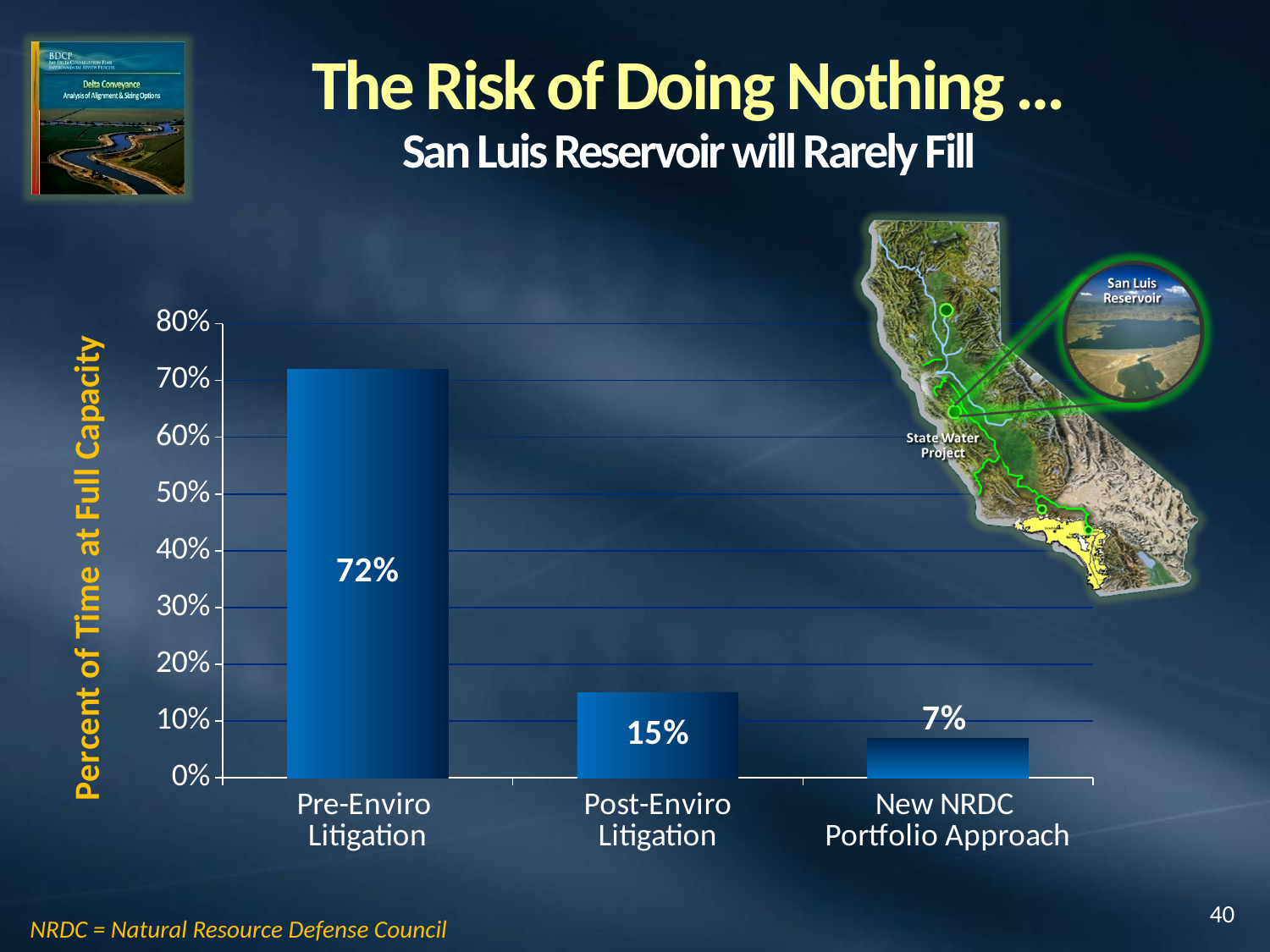
What is the value for New NRDC Portfolio Approach? 7% How many categories are shown on the x axis? 3 What kind of chart is shown on the slide? bar chart Which is larger, the value for Post-Enviro Litigation or the value for New NRDC Portfolio Approach? Post-Enviro Litigation What is the label of the y axis? Percent of Time at Full Capacity What is the difference between the values for Post-Enviro Litigation and New NRDC Portfolio Approach? 8% What is the value for Pre-Enviro Litigation? 72% What is the difference between the values for Pre-Enviro Litigation and Post-Enviro Litigation? 57% Which category has the lowest percent of time at full capacity? New NRDC Portfolio Approach Which category has the highest percent of time at full capacity? Pre-Enviro Litigation What is the value for Post-Enviro Litigation? 15% Is the value for Pre-Enviro Litigation greater or less than 60%? greater